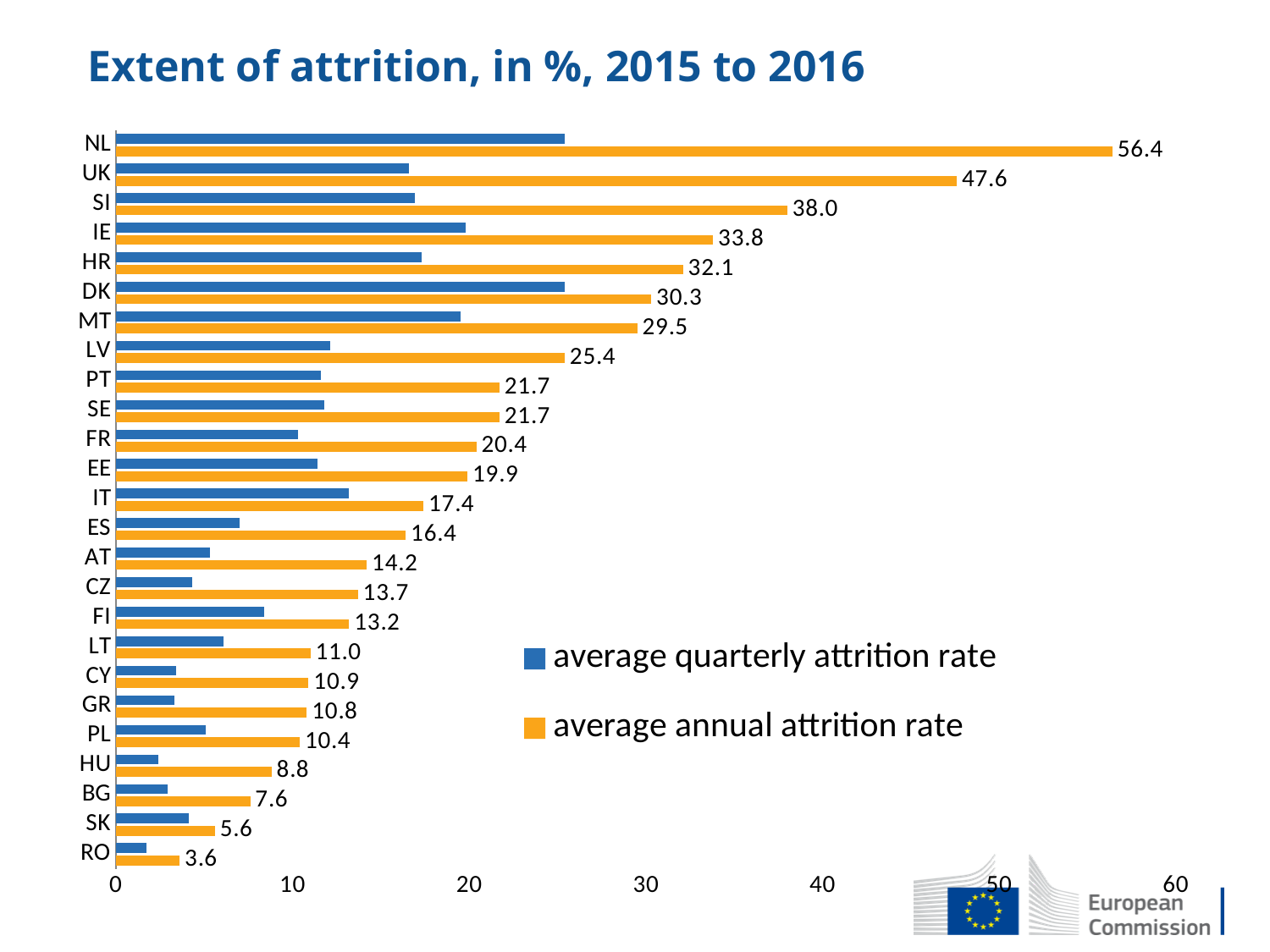
Is the average quarterly attrition rate for RO greater or less than 10? less What is the difference between the average annual attrition rates of NL and UK? 8.8 Which has a higher average annual attrition rate, SI or IE? SI What is the average annual attrition rate for HU? 8.8 What type of chart is shown on the slide? Bar chart How many series does the legend list? 2 What is the average annual attrition rate for IT? 17.4 What is the average annual attrition rate for NL? 56.4 Is the average quarterly attrition rate for NL greater or less than 20? greater How many countries are shown on the chart? 25 Which country has the lowest average annual attrition rate? RO Which country has the highest average annual attrition rate? NL